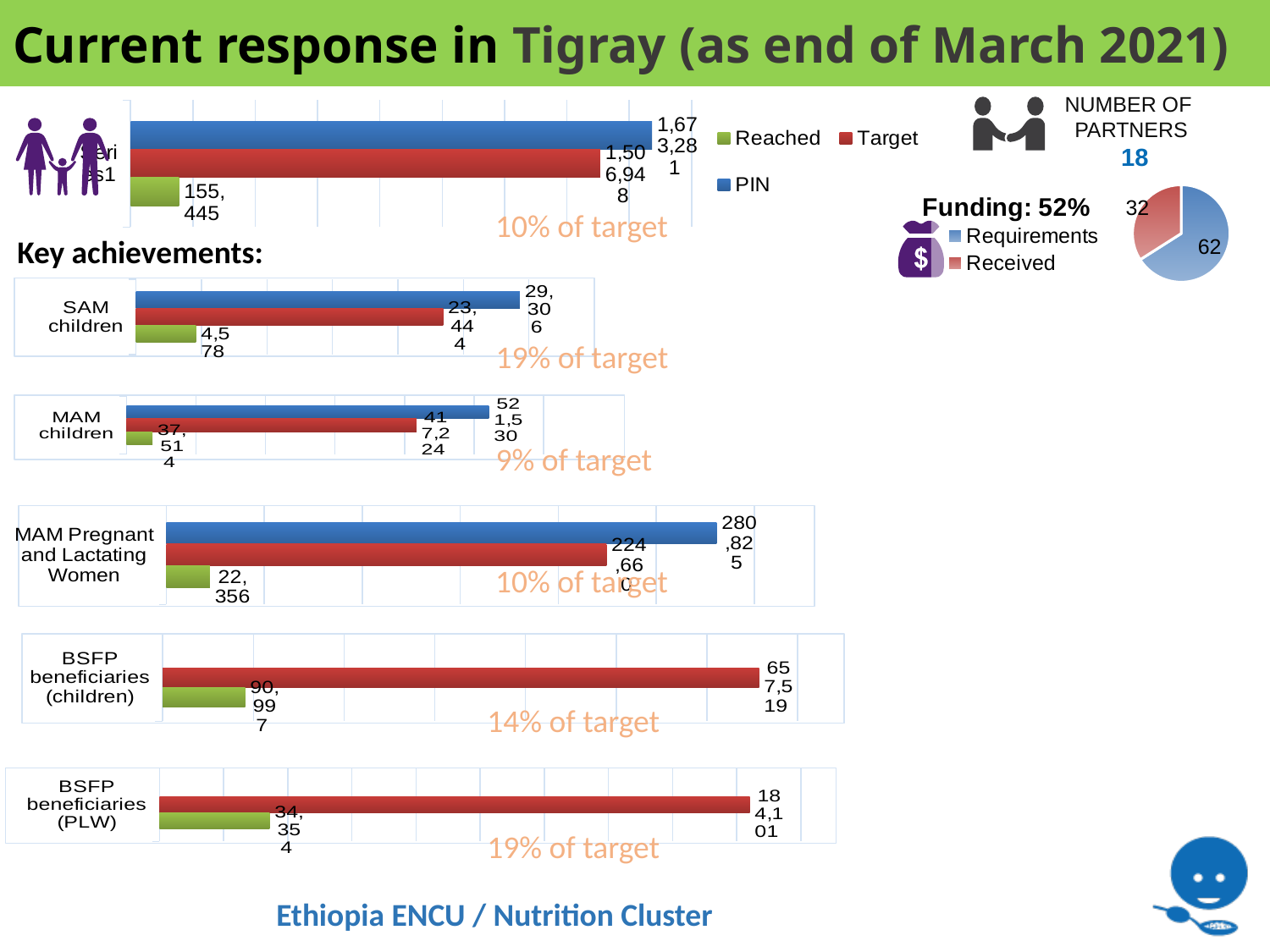
In the 'SAM children' chart, which is larger, PIN or Target? PIN In the 'SAM children' chart, what is the value for Reached? 4,578 What percentage of target is shown on the 'MAM children' chart? 9% of target In the 'BSFP beneficiaries (children)' chart, what is the value for Reached? 90,997 In the top bar chart, what is the value for Reached? 155,445 How many series does the legend for the bar charts list? 3 In the 'MAM children' chart, which series has the highest value? PIN In the Funding pie chart, what is the value for Requirements? 62 What kind of chart is the 'SAM children' chart? bar chart In the 'BSFP beneficiaries (PLW)' chart, what is the value for Reached? 34,354 In the 'MAM Pregnant and Lactating Women' chart, what is the value for Reached? 22,356 In the Funding pie chart, what is the difference between Requirements and Received? 30